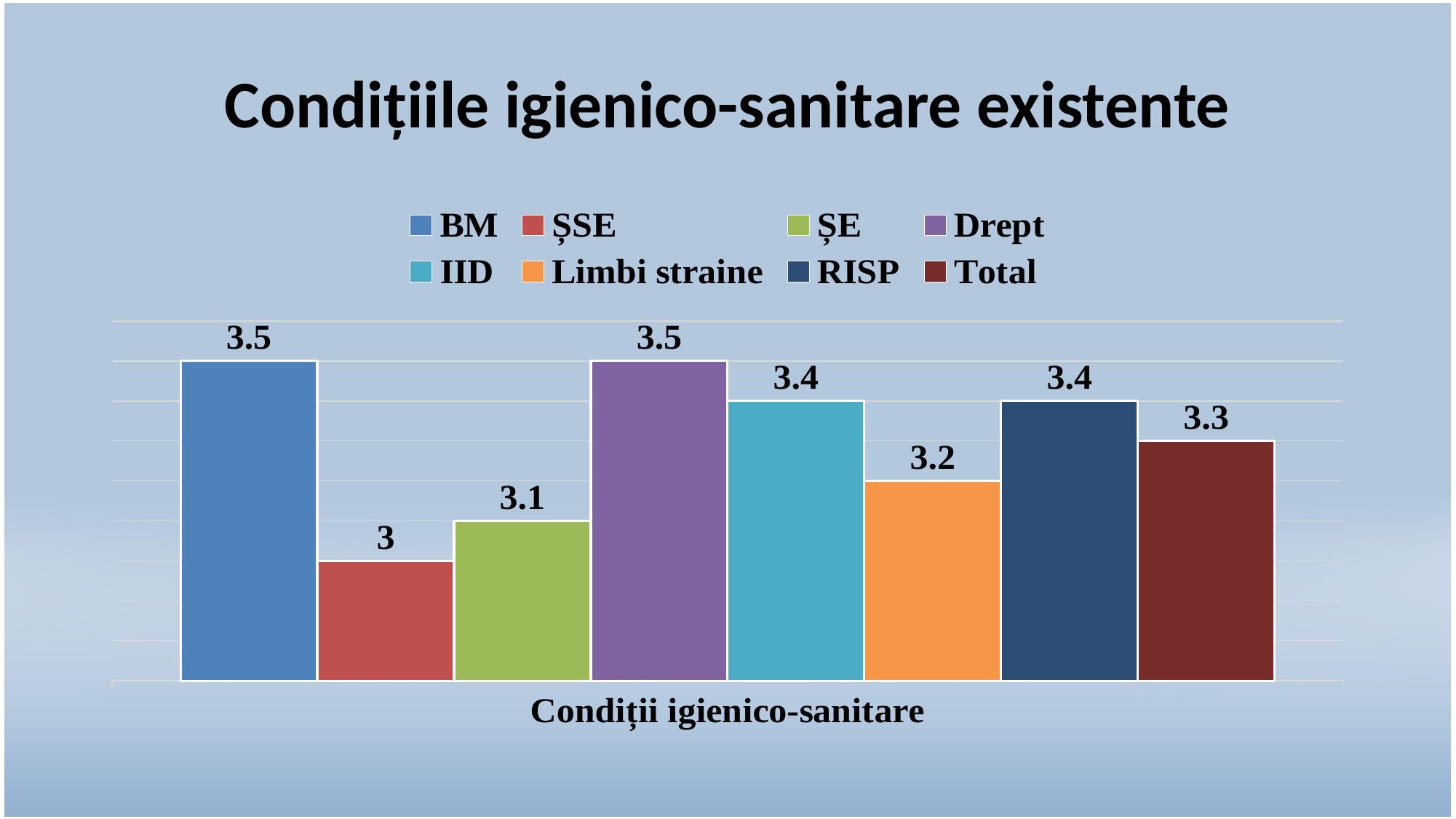
Which is larger, the value for ȘE or the value for Total? Total What is the value for Limbi straine? 3.2 What is the title of the slide? Condițiile igienico-sanitare existente Which series has the lowest value? ȘSE What is the difference between the values for Drept and ȘE? 0.4 How many series does the legend list? 8 What is the value for Total? 3.3 What is the value for IID? 3.4 What is the value for ȘSE? 3 What is the difference between the values for RISP and Limbi straine? 0.2 What is the value for BM? 3.5 What kind of chart is shown on the slide? Bar chart